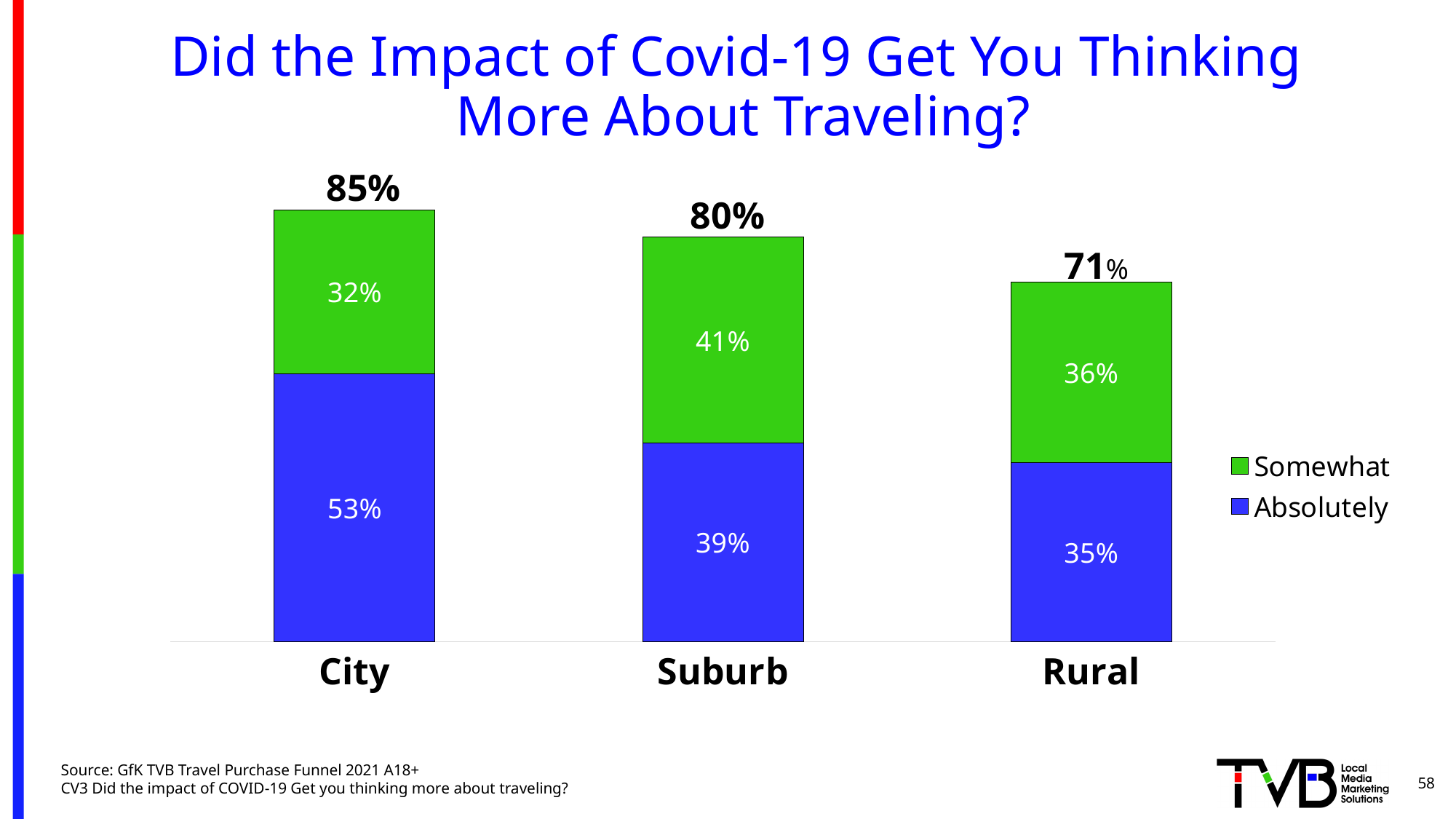
How many series does the legend list? 2 How many categories are shown on the x axis? 3 What is the 'Somewhat' value for Suburb? 41% What kind of chart is shown on the slide? Stacked bar chart What is the 'Absolutely' value for City? 53% What is the total of the stacked bar for Suburb? 80% Which category has the highest total? City What is the 'Absolutely' value for Rural? 35% Which is larger, the 'Somewhat' value for Rural or the 'Somewhat' value for City? Rural Which colour represents the 'Somewhat' series? Green Which category has the lowest 'Absolutely' value? Rural What is the difference between the 'Absolutely' values for City and Suburb? 14%